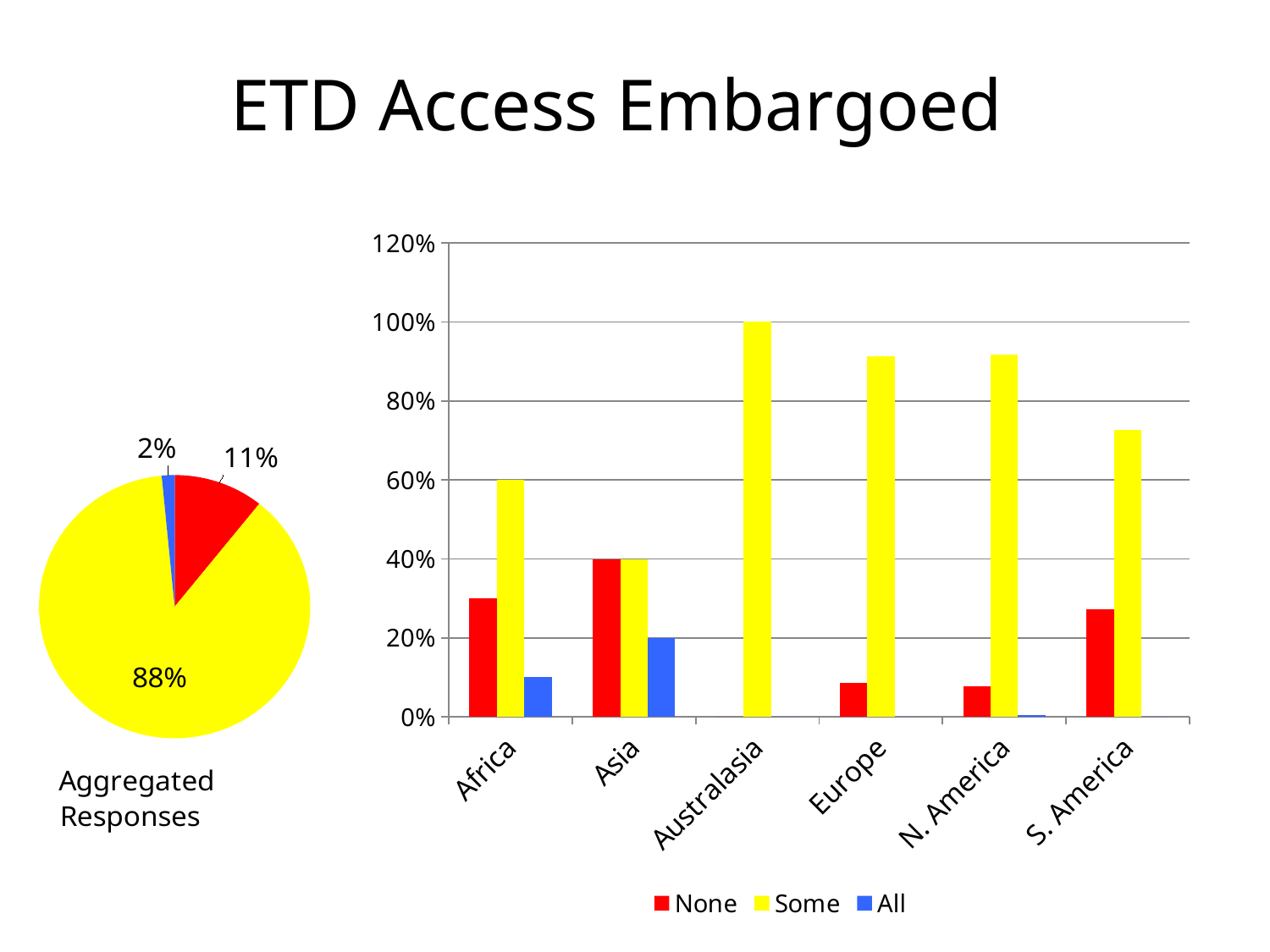
What kind of chart is the 'Aggregated Responses' chart on the left? pie chart In the bar chart, is the 'None' value for Africa greater or less than 20%? greater In the bar chart, what is the value of the 'All' bar for Asia? 20% In the bar chart, what is the value of the 'Some' bar for Australasia? 100% In the bar chart, how many regions are shown on the x axis? 6 In the 'Aggregated Responses' pie chart, what share does the largest slice represent? 88% In the bar chart, how many series does the legend list? 3 What kind of chart is the chart on the right of the slide? bar chart In the bar chart, which region has the lowest 'Some' bar? Asia In the bar chart, which region has the highest 'Some' bar? Australasia In the bar chart, what is the value of the 'Some' bar for Africa? 60% In the bar chart, which is larger: the 'None' bar for Asia or the 'None' bar for Africa? Asia